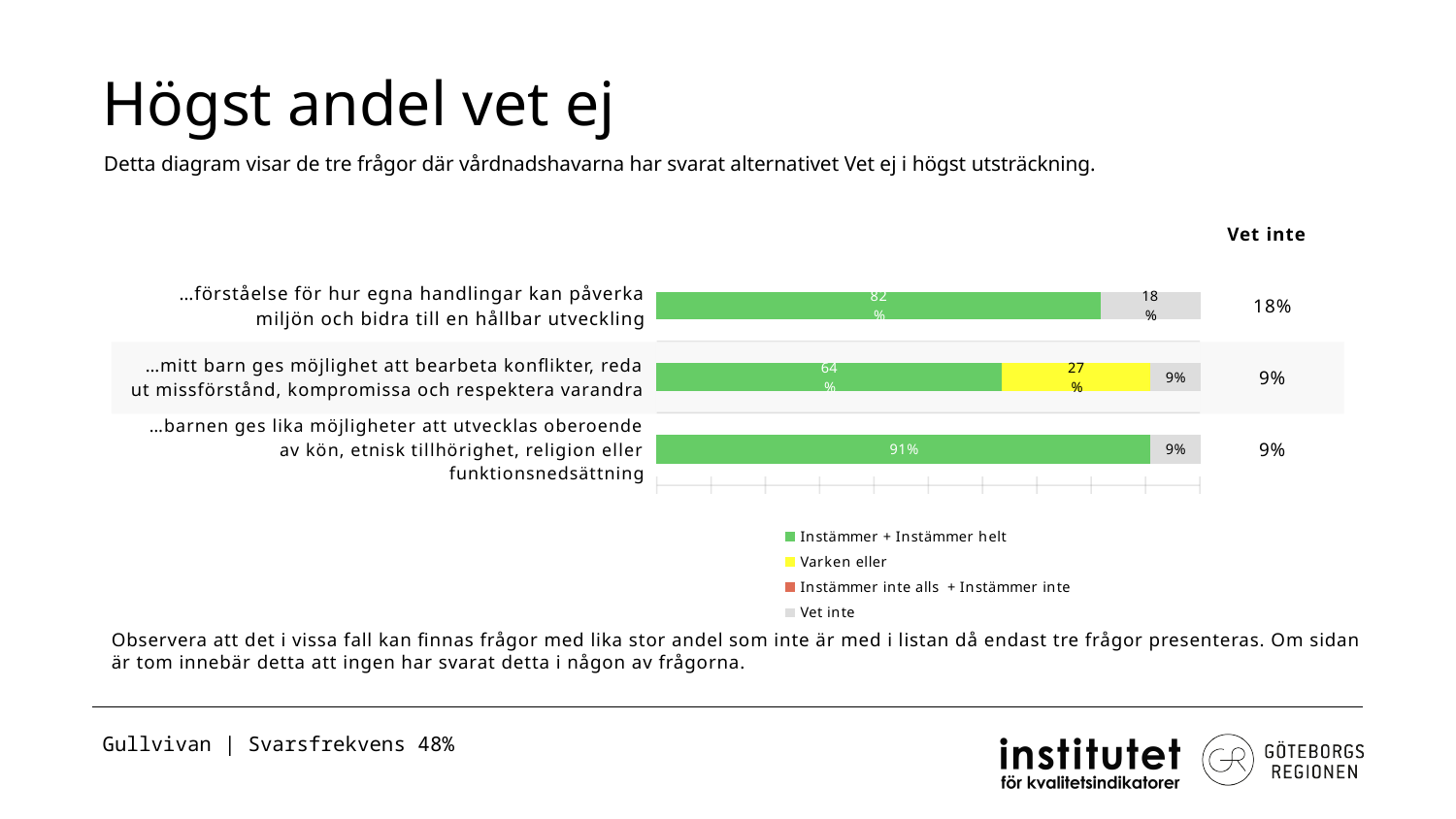
What type of chart is shown on the slide? Stacked bar chart Which category has the highest 'Instämmer + Instämmer helt' share? …barnen ges lika möjligheter att utvecklas oberoende av kön, etnisk tillhörighet, religion eller funktionsnedsättning What is the 'Instämmer + Instämmer helt' value for '…förståelse för hur egna handlingar kan påverka miljön och bidra till en hållbar utveckling'? 82% Which legend entry is shown in yellow? Varken eller How many categories (questions) are plotted in the chart? 3 What is the 'Instämmer + Instämmer helt' value for '…barnen ges lika möjligheter att utvecklas oberoende av kön, etnisk tillhörighet, religion eller funktionsnedsättning'? 91% What is the 'Vet inte' value for '…förståelse för hur egna handlingar kan påverka miljön och bidra till en hållbar utveckling'? 18% Which category has the lowest 'Instämmer + Instämmer helt' share? …mitt barn ges möjlighet att bearbeta konflikter, reda ut missförstånd, kompromissa och respektera varandra What is the difference between the 'Vet inte' value for '…förståelse för hur egna handlingar kan påverka miljön…' and for '…mitt barn ges möjlighet att bearbeta konflikter…'? 9% What is the 'Varken eller' value for '…mitt barn ges möjlighet att bearbeta konflikter, reda ut missförstånd, kompromissa och respektera varandra'? 27% Which is larger: the 'Instämmer + Instämmer helt' value for '…förståelse för hur egna handlingar kan påverka miljön…' or for '…mitt barn ges möjlighet att bearbeta konflikter…'? …förståelse för hur egna handlingar kan påverka miljön och bidra till en hållbar utveckling How many series does the chart legend list? 4